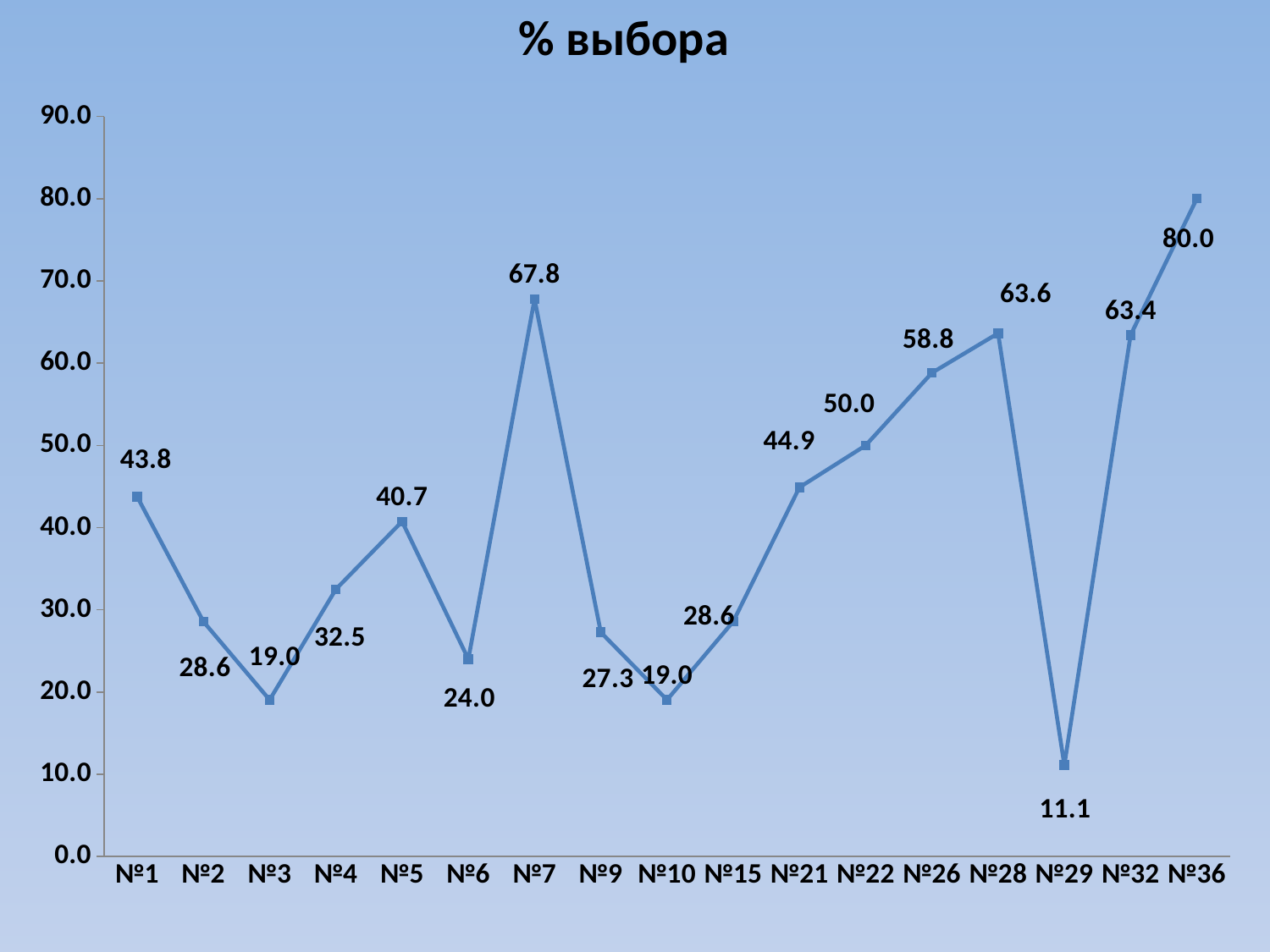
Which category has the lowest value? №29 Which category has the highest value? №36 Is the value for №26 greater or less than 50.0? greater What is the value for №22? 50.0 What is the value for №7? 67.8 What is the difference between the values for №36 and №29? 68.9 What is the difference between the values for №7 and №6? 43.8 What is the value for №29? 11.1 How many categories are plotted on the x axis? 17 What kind of chart is shown on the slide? line chart What is the title of the chart? % выбора Which is larger, the value for №5 or the value for №4? №5